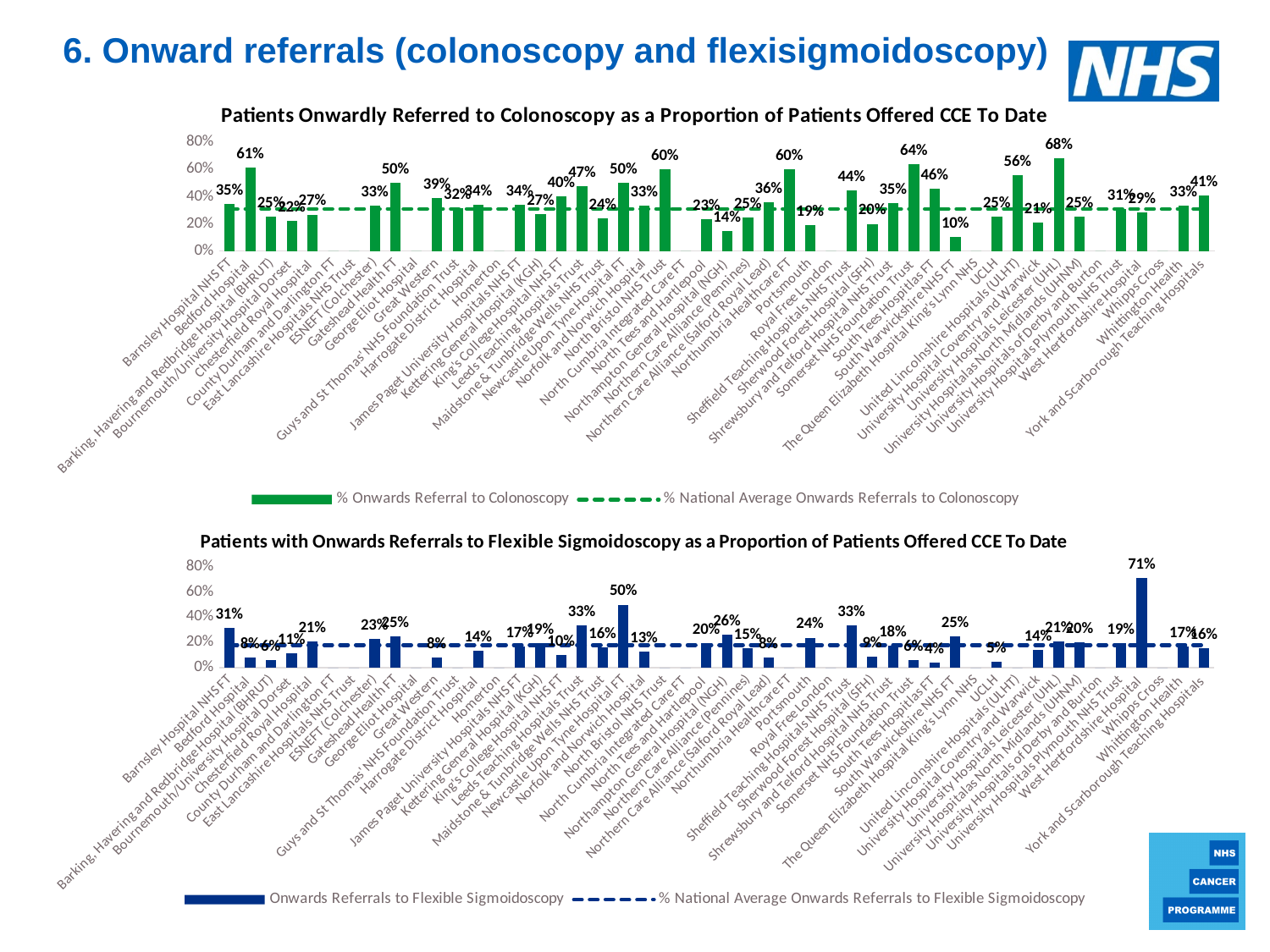
In the top chart (colonoscopy referrals), which is larger: the value for Barnsley Hospital NHS FT or Bedford Hospital? Bedford Hospital How many series does the legend of the top chart (colonoscopy referrals) list? 2 In the top chart (colonoscopy referrals), what is the lowest percentage shown on any bar? 10% In the top chart (colonoscopy referrals), what is the highest percentage shown on any bar? 68% In the top chart (colonoscopy referrals), what is the value for York and Scarborough Teaching Hospitals? 41% In the top chart (colonoscopy referrals), what is the value for Barnsley Hospital NHS FT? 35% In the top chart (colonoscopy referrals), what does the dashed line represent according to the legend? % National Average Onwards Referrals to Colonoscopy In the bottom chart (flexible sigmoidoscopy referrals), what is the value for Barnsley Hospital NHS FT? 31% What type of chart is the top chart, 'Patients Onwardly Referred to Colonoscopy as a Proportion of Patients Offered CCE To Date'? Bar chart In the bottom chart (flexible sigmoidoscopy referrals), what is the highest percentage shown on any bar? 71% In the top chart (colonoscopy referrals), what is the value for Bedford Hospital? 61% In the top chart (colonoscopy referrals), what is the difference between the values for Bedford Hospital and Barnsley Hospital NHS FT? 26%